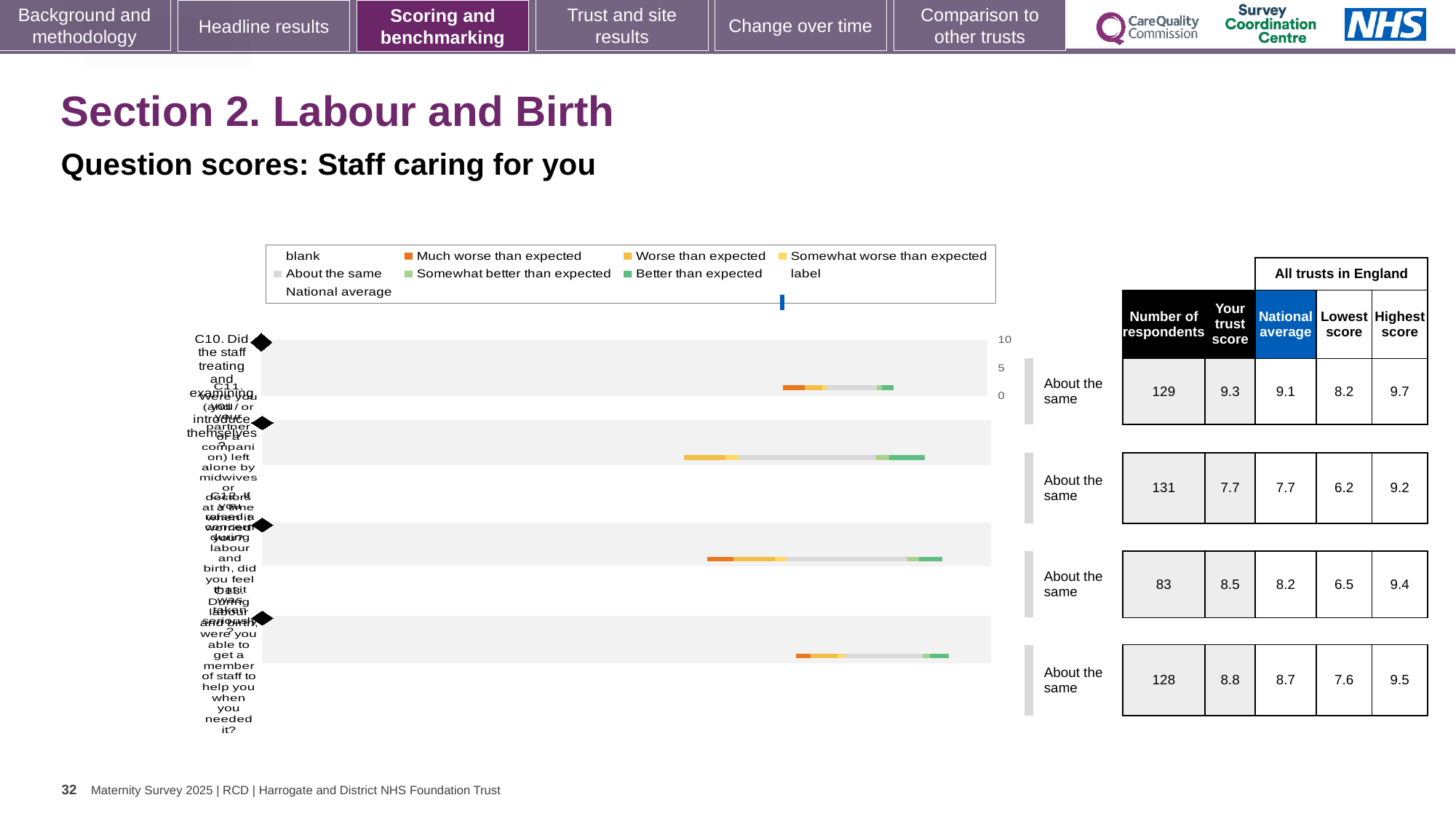
What kind of chart is shown on the slide? Bar chart How many entries does the chart legend list? 9 What colour represents 'Much worse than expected' in the chart legend? Orange In the table beside the chart, what is the difference between the highest score and the lowest score for the first row? 1.5 In the table beside the chart, is the 'Your trust score' higher for the first row or the fourth row? The first row (9.3) What benchmark category is shown beside every row of the chart? About the same In the table beside the chart, what is the 'Your trust score' for the first row (C10)? 9.3 In the table beside the chart, what is the national average for the second row? 7.7 Which row in the table beside the chart has the lowest number of respondents? The third row (83) Which row in the table beside the chart has the highest number of respondents? The second row (131) How many question rows (bars) does the chart show? 4 In the table beside the chart, what is the lowest score for the third row? 6.5